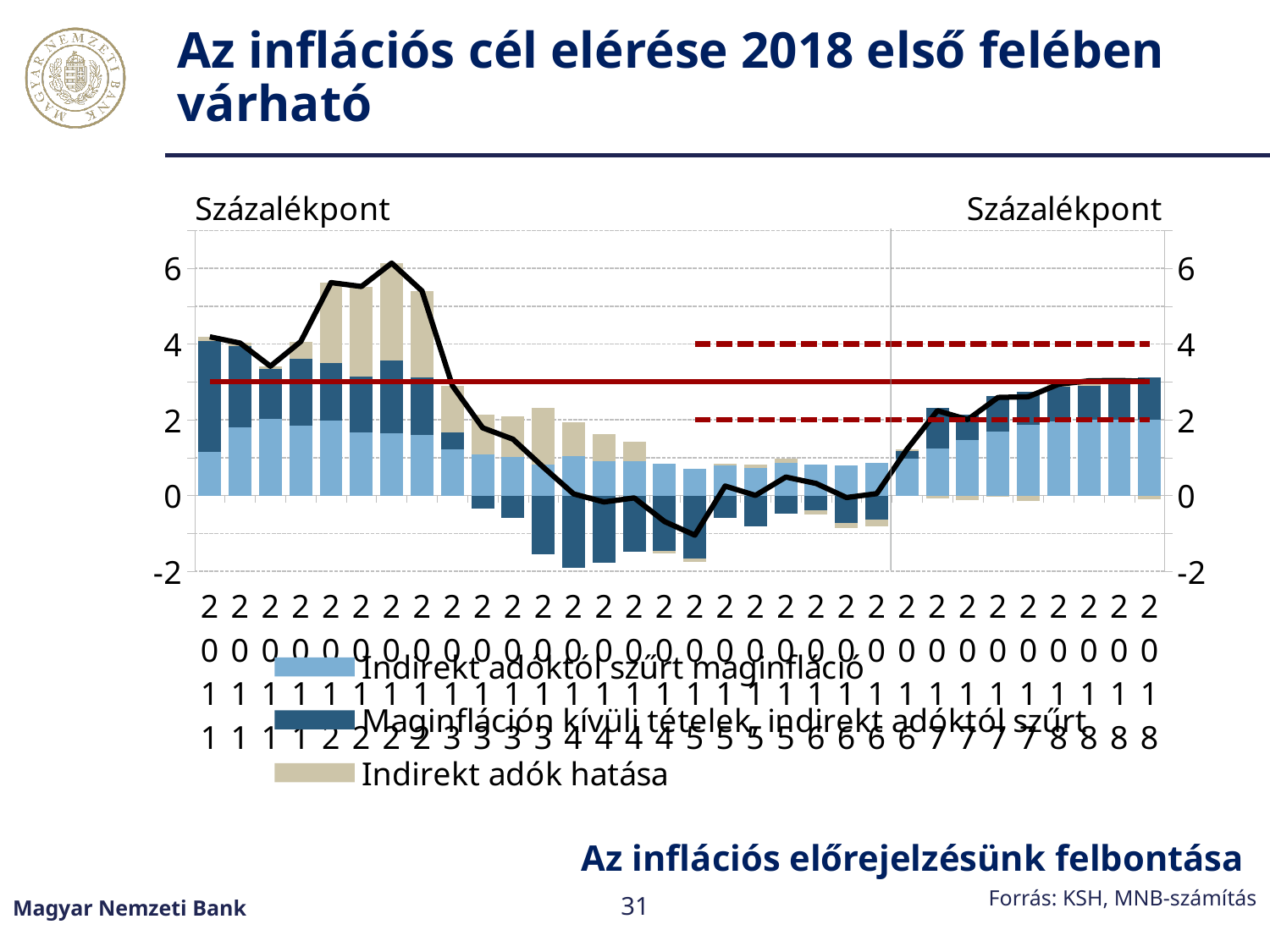
Does the black line rise or fall from its 2012 peak to 2015? fall Is the highest point of the black line greater or less than 4? greater What kind of chart is shown on the slide? Stacked bar chart with a line Is the black line at the end of 2018 greater or less than 2? greater Is the lowest point of the black line greater or less than 0? less Does the black line rise or fall from 2016 to 2018? rise What unit label is shown at the top of the vertical axes? Százalékpont How many series does the legend list? 3 What is the title of the chart? Az inflációs előrejelzésünk felbontása How many bars (quarters) are plotted on the chart? 32